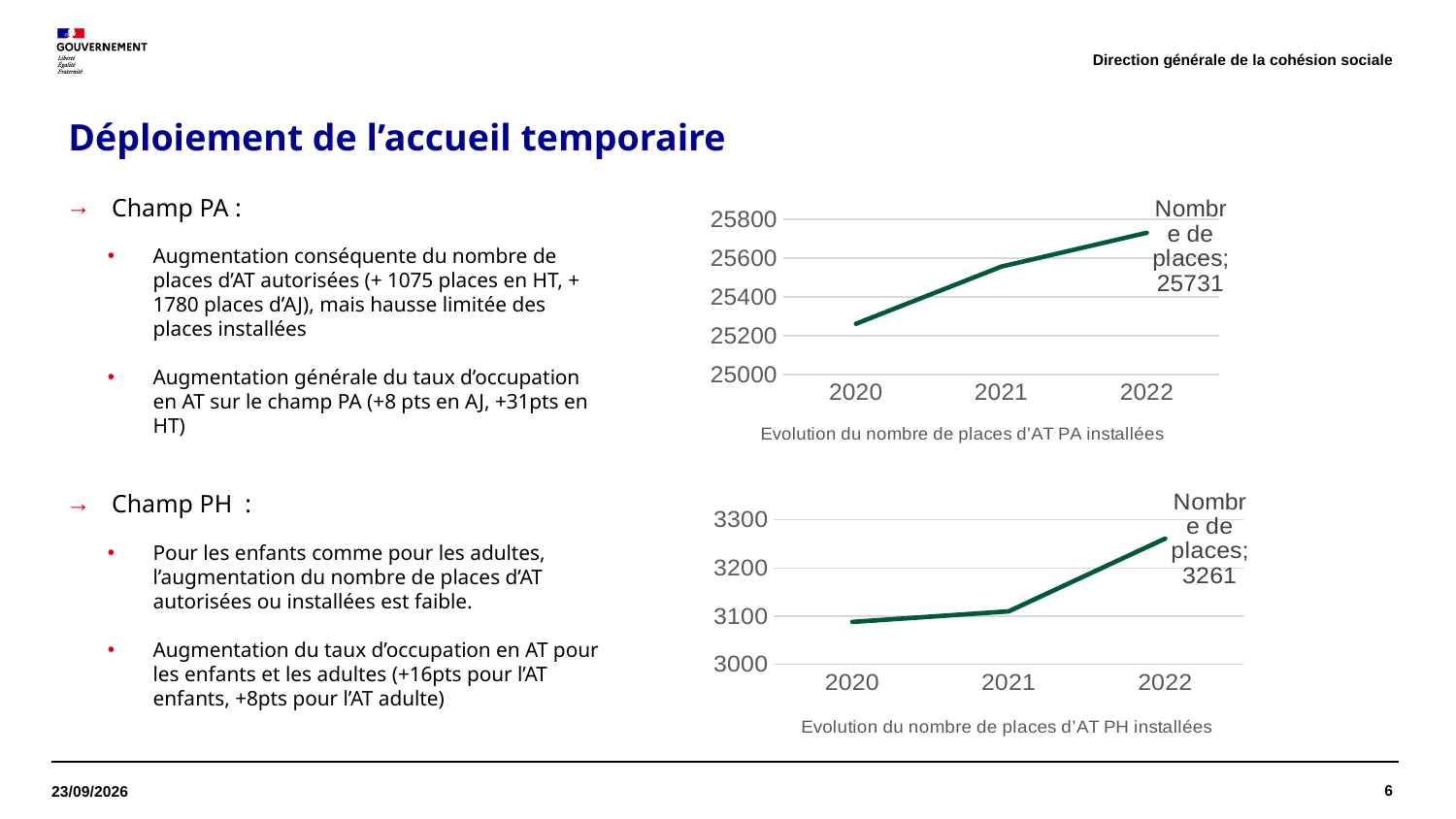
In the chart 'Evolution du nombre de places d'AT PH installées', is the value for 2021 greater or less than 3200? less In the chart 'Evolution du nombre de places d'AT PH installées', do the values rise or fall from 2020 to 2022? rise In the chart 'Evolution du nombre de places d'AT PA installées', is the value for 2020 greater or less than 25400? less In the chart 'Evolution du nombre de places d'AT PA installées', which year has the lowest value? 2020 In the chart 'Evolution du nombre de places d'AT PA installées', do the values rise or fall from 2020 to 2022? rise How many years are plotted on the x axis of the chart 'Evolution du nombre de places d'AT PA installées'? 3 In the chart 'Evolution du nombre de places d'AT PH installées', what is the number of places in 2022? 3261 In the chart 'Evolution du nombre de places d'AT PA installées', what is the number of places in 2022? 25731 In the chart 'Evolution du nombre de places d'AT PA installées', which is larger, the value for 2021 or the value for 2020? 2021 What kind of chart is the chart titled 'Evolution du nombre de places d'AT PA installées'? line chart In the chart 'Evolution du nombre de places d'AT PA installées', which year has the highest value? 2022 In the chart 'Evolution du nombre de places d'AT PH installées', which year has the highest value? 2022